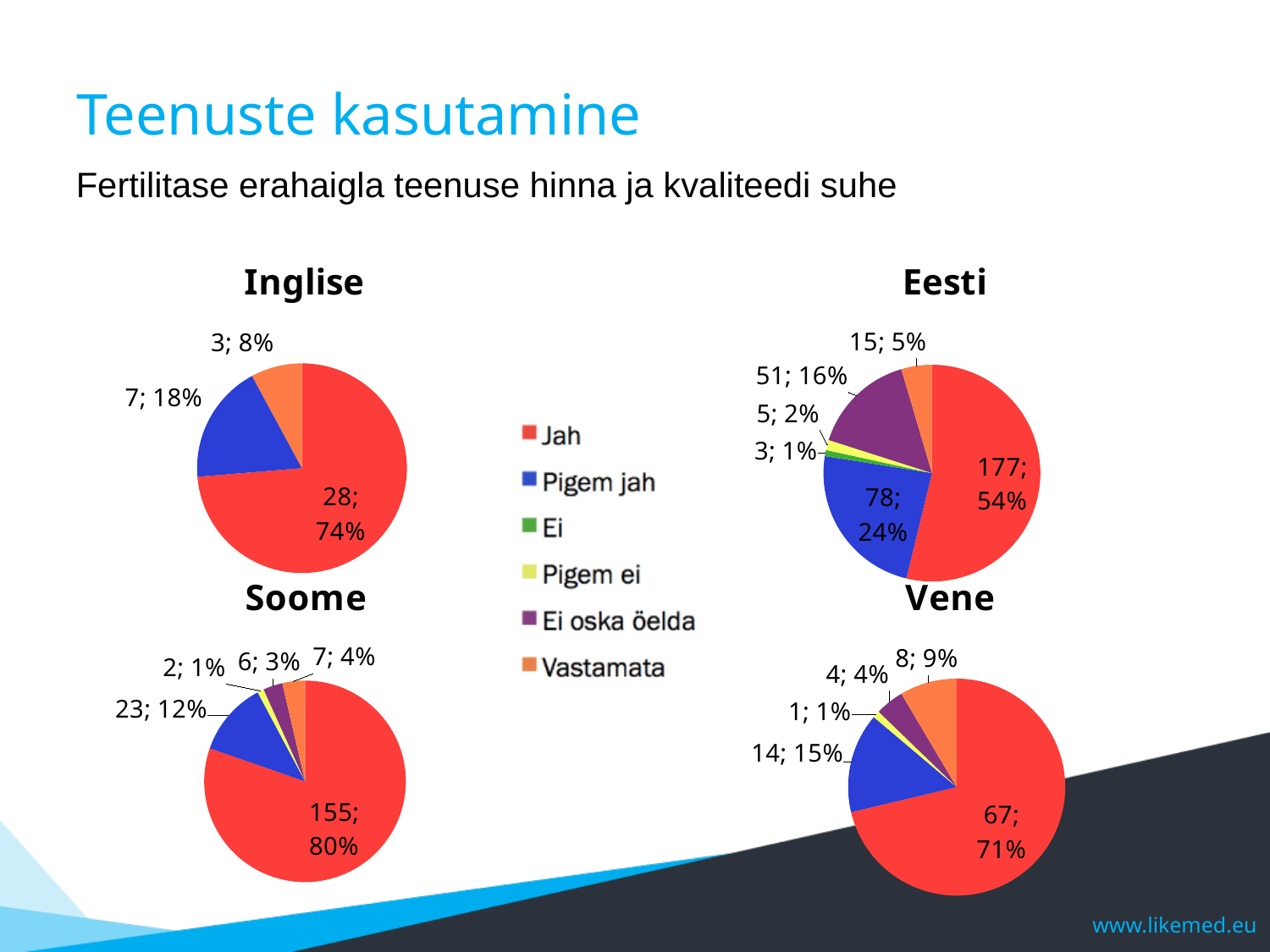
How many series does the legend list? 6 What type of charts are shown on the slide? Pie charts In the Eesti chart, which category is the largest? Jah In the Soome chart, what is the value for Jah? 155; 80% In the Vene chart, which is larger, Vastamata or Ei oska öelda? Vastamata In the Soome chart, which category is the smallest? Pigem ei In the Vene chart, what is the count for Pigem jah? 14 In the Eesti chart, what share of the pie is Pigem jah? 24% How many slices does the Inglise chart have? 3 In the Inglise chart, what is the value for Jah? 28; 74% In the Eesti chart, what is the difference between the counts for Jah and Pigem jah? 99 What is the title of the chart in the top right? Eesti